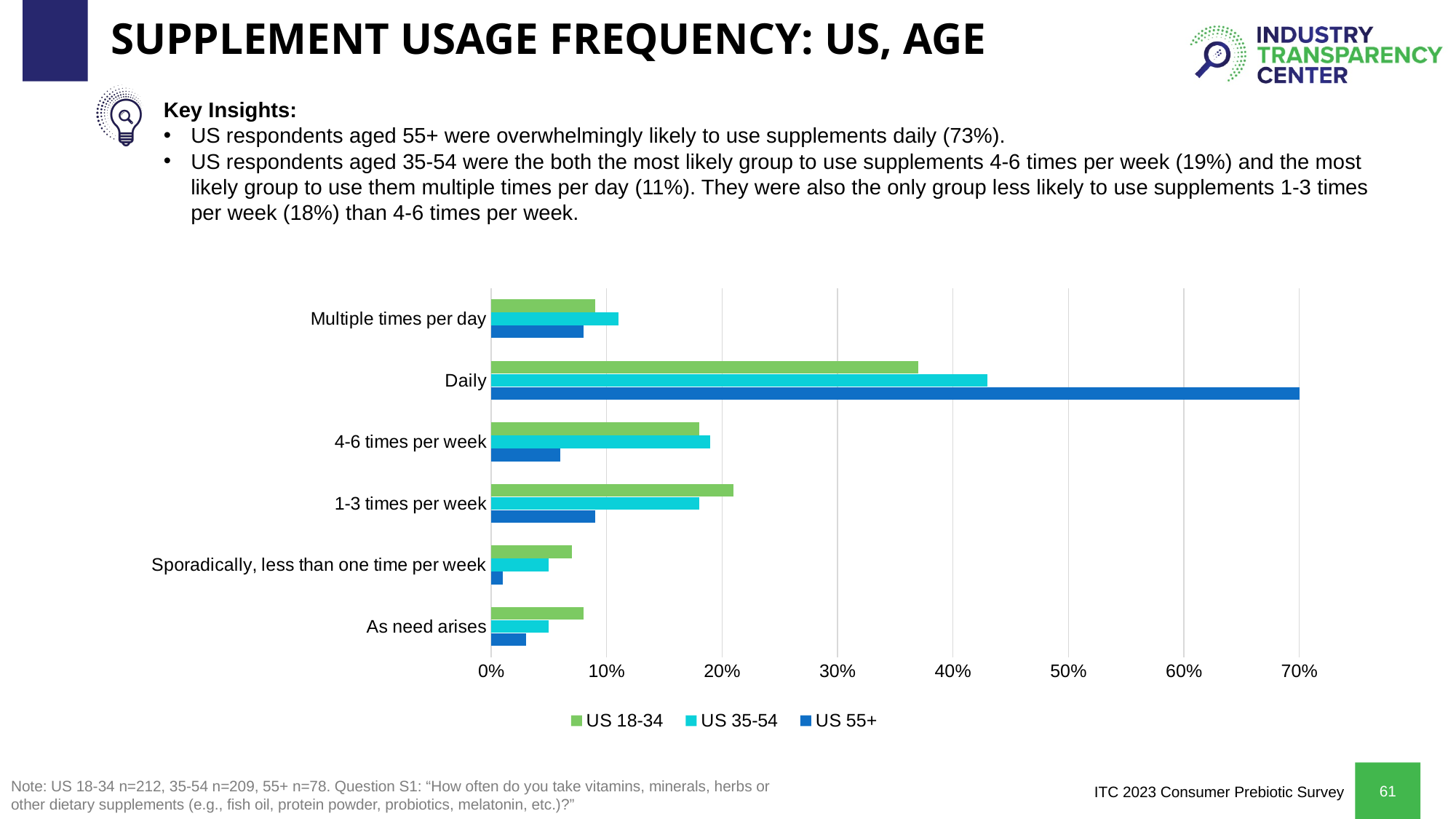
Is the value for US 55+ in the Daily category greater or less than 60%? greater Which usage frequency category has the highest value for US 55+? Daily Is the value for US 18-34 in the Daily category greater or less than 30%? greater In the 4-6 times per week category, which is larger: US 35-54 or US 55+? US 35-54 Is the value for US 55+ in the 4-6 times per week category greater or less than 10%? less What kind of chart is shown on the slide? bar chart How many usage frequency categories are plotted on the chart? 6 What are the three series listed in the chart legend? US 18-34, US 35-54, US 55+ How many series does the chart legend list? 3 Which usage frequency category has the lowest value for US 55+? Sporadically, less than one time per week In the Daily category, which is larger: US 55+ or US 18-34? US 55+